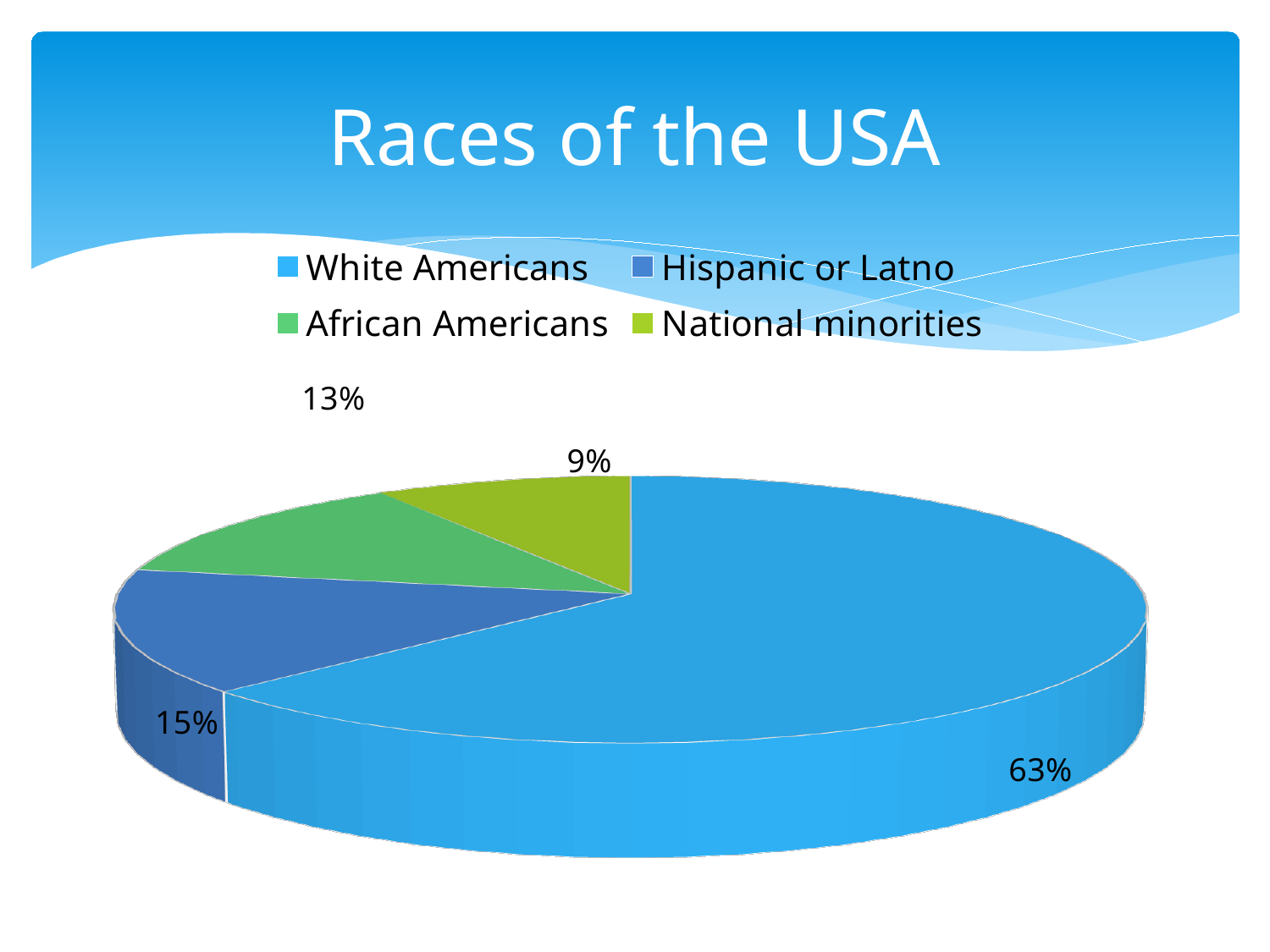
How many categories does the legend list? 4 What is the difference between the White Americans share and the Hispanic or Latno share? 48% What is the title of the chart? Races of the USA What percentage of the pie is African Americans? 13% Which category has the smallest share of the pie? National minorities What kind of chart is shown on the slide? pie chart Which category has the largest share of the pie? White Americans Which is larger, the share for Hispanic or Latno or the share for African Americans? Hispanic or Latno What colour is the slice for National minorities? yellow-green What percentage of the pie is White Americans? 63% What percentage of the pie is National minorities? 9% What percentage of the pie is Hispanic or Latno? 15%